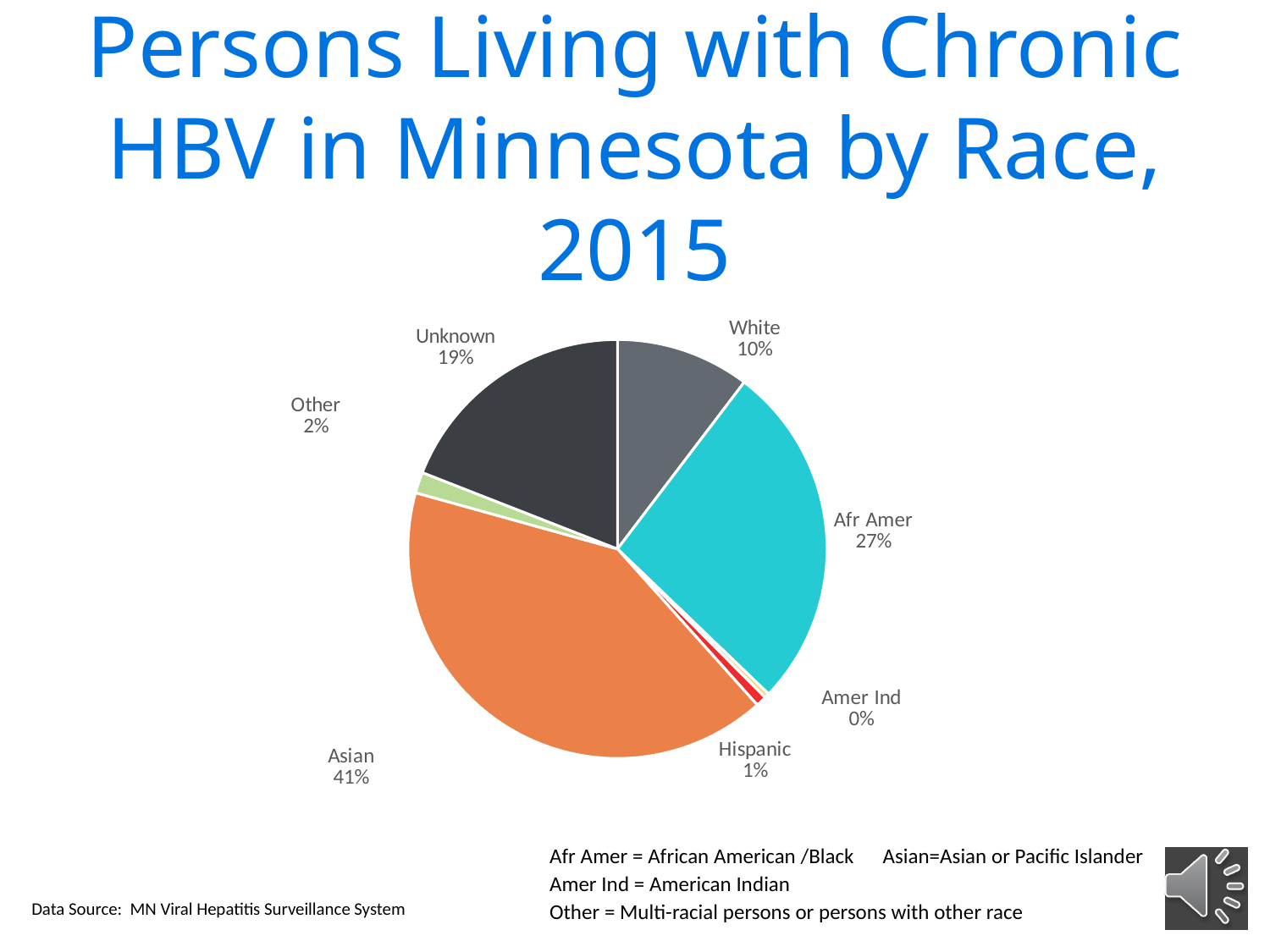
How many percentage points larger is the Asian share than the Afr Amer share? 14 Which race category has the largest share of the pie? Asian What percentage is shown for Hispanic? 1% What is the title of the chart? Persons Living with Chronic HBV in Minnesota by Race, 2015 What type of chart is shown on the slide? pie chart What share of persons living with chronic HBV in Minnesota is Asian? 41% Which race category has the smallest share of the pie? Amer Ind What share is shown for the Unknown category? 19% What percentage is shown for White? 10% Which is larger, the share for Unknown or the share for White? Unknown What percentage of the pie is labelled Afr Amer? 27% How many race categories are shown in the pie chart? 7